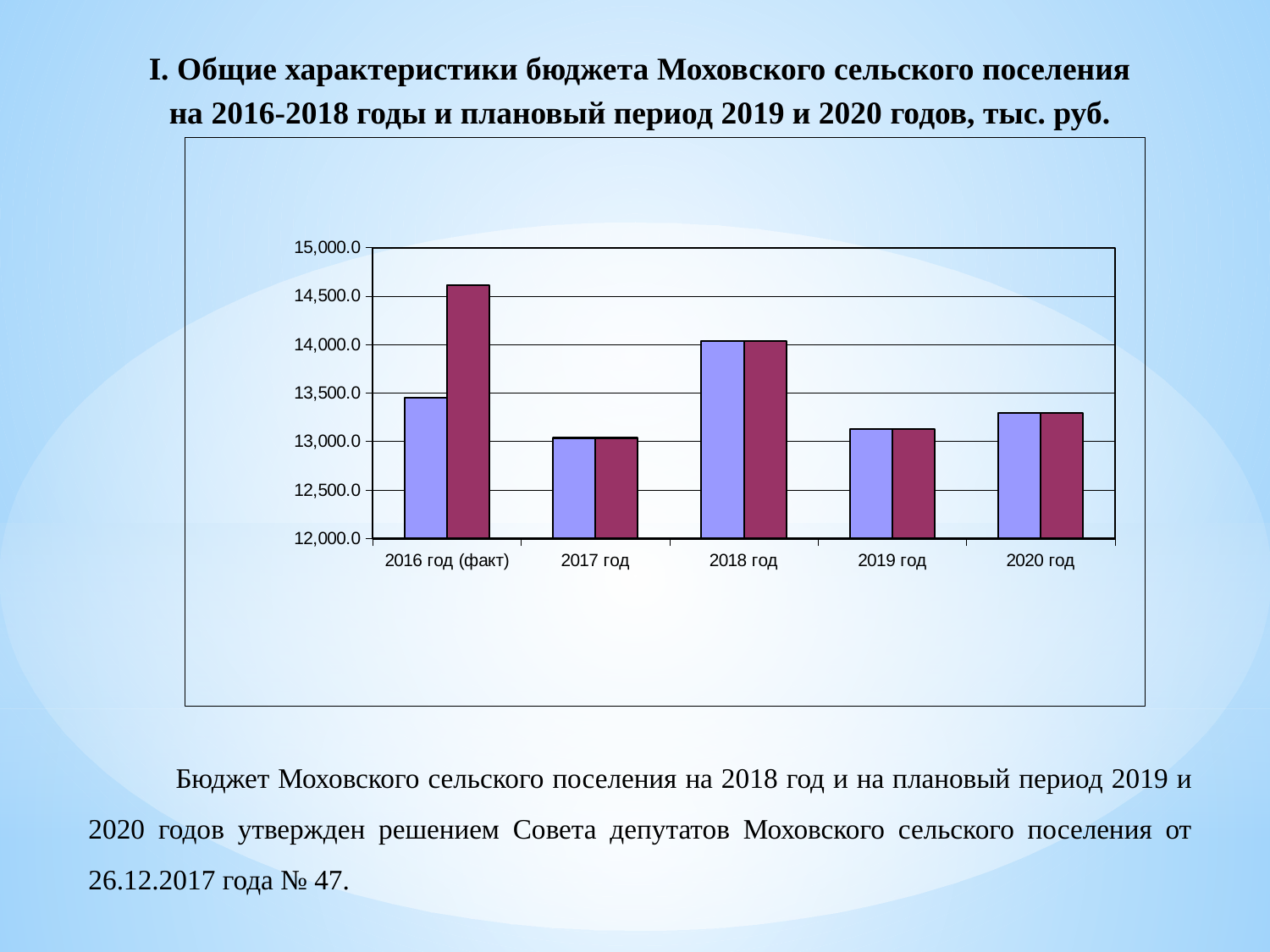
Is the value of the blue (left) bar for 2016 год (факт) greater or less than 14,000.0? less Is the value of the blue (left) bar for 2018 год greater or less than 13,500.0? greater How many categories are shown on the x axis of the chart? 5 Is the value of the blue (left) bar for 2017 год greater or less than 13,500.0? less How many bars are plotted for each year category in the chart? 2 Which category has the shortest blue (left) bar? 2017 год For 2016 год (факт), which bar is taller, the blue (left) one or the purple (right) one? the purple (right) one What kind of chart is shown on the slide? bar chart Which category has the tallest purple (right) bar? 2016 год (факт)